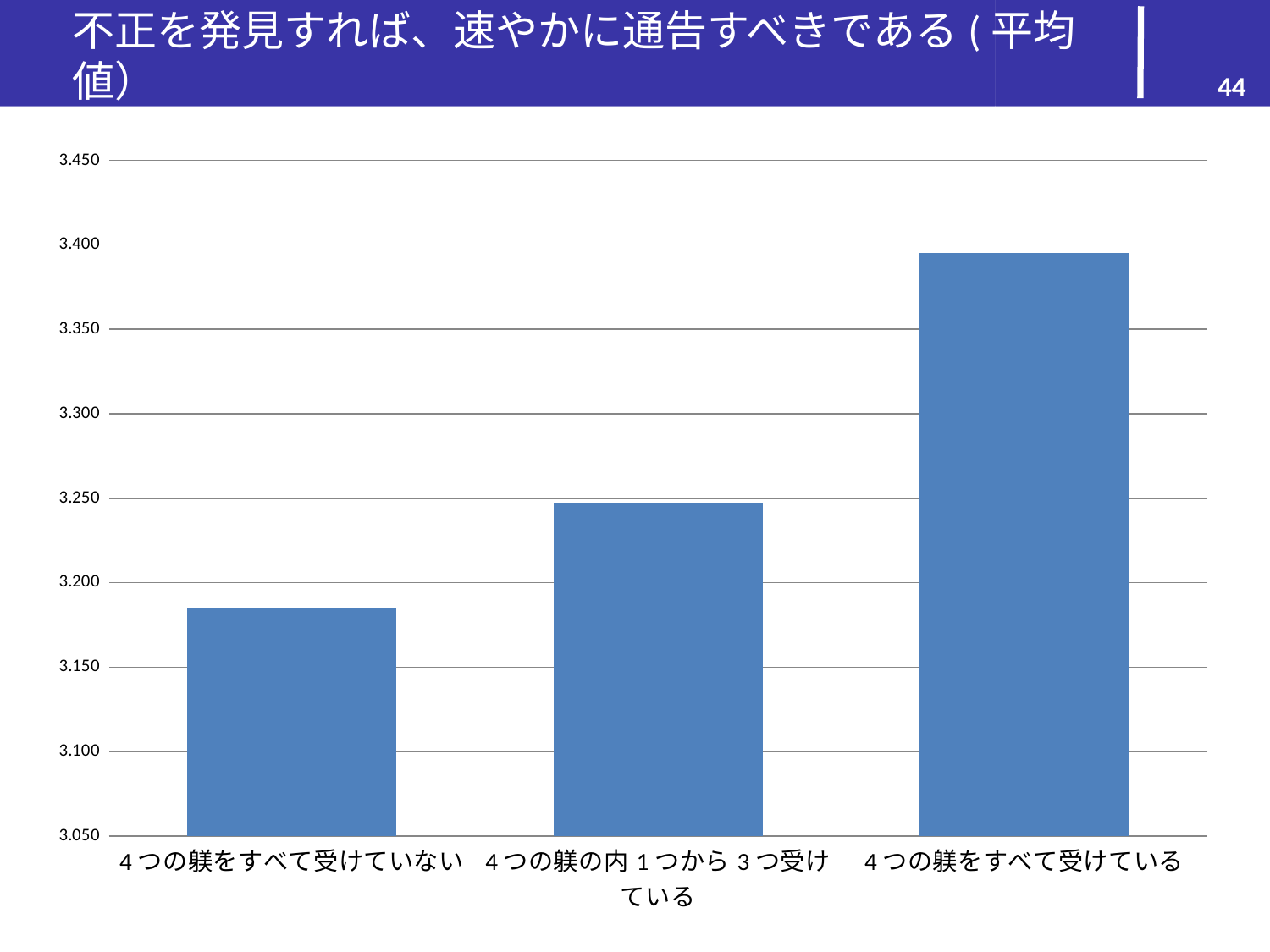
Is the value for 4つの躾の内1つから3つ受けている greater or less than 3.200? greater What is the title of the slide? 不正を発見すれば、速やかに通告すべきである(平均値) Which category has the lowest value? 4つの躾をすべて受けていない What kind of chart is shown on the slide? bar chart Is the value for 4つの躾をすべて受けている greater or less than 3.350? greater Is the value for 4つの躾をすべて受けていない greater or less than 3.200? less How many categories are plotted on the chart? 3 What is the lowest value shown on the vertical axis? 3.050 Which is larger, the value for 4つの躾の内1つから3つ受けている or the value for 4つの躾をすべて受けている? 4つの躾をすべて受けている Do the values rise or fall from left to right along the x axis? rise Which category has the highest value? 4つの躾をすべて受けている